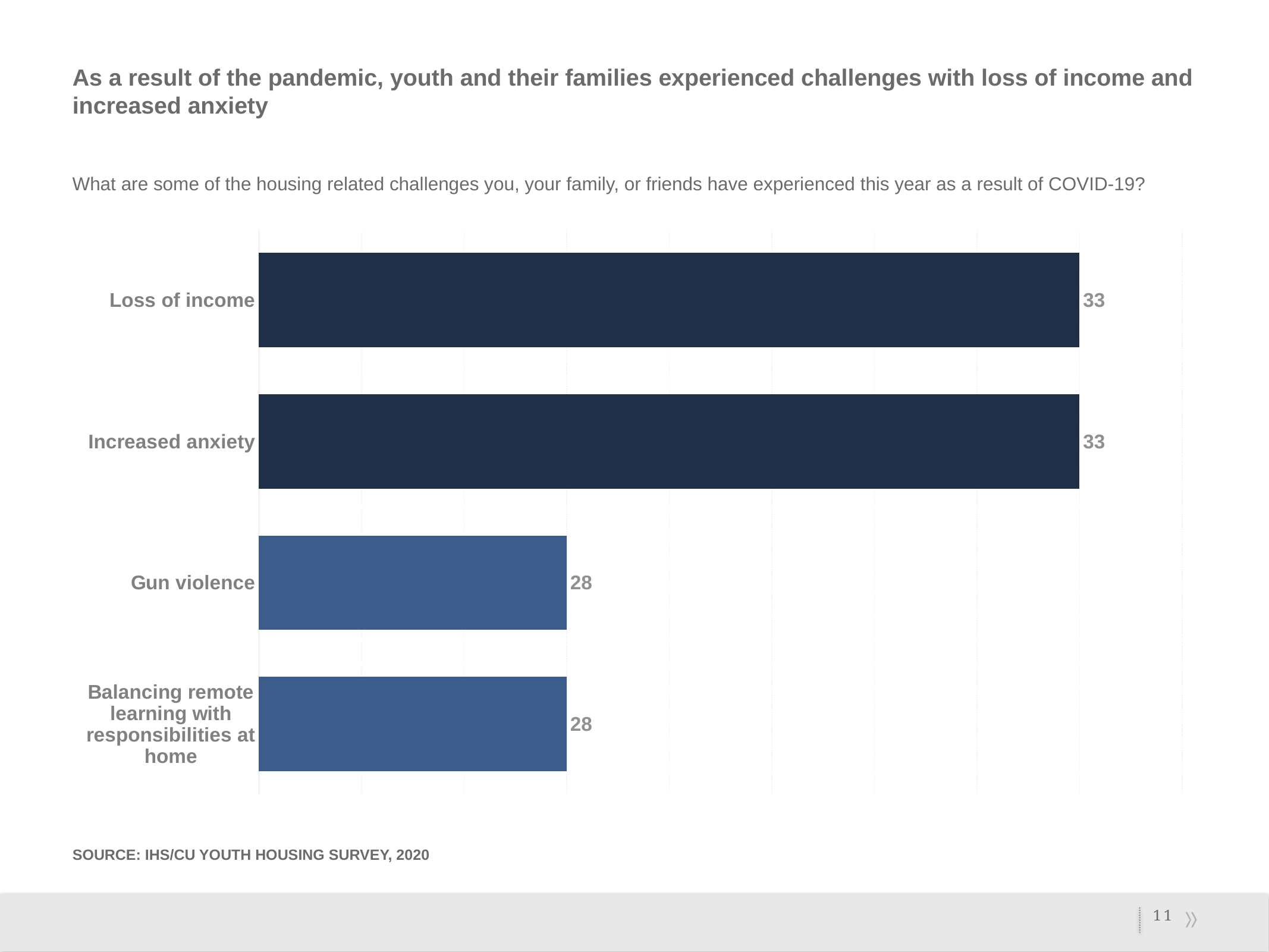
What is the value for Balancing remote learning with responsibilities at home? 28 How many categories are shown in the chart? 4 What kind of chart is shown on the slide? Bar chart Which two categories share the highest value in the chart? Loss of income and Increased anxiety What is the value for Increased anxiety? 33 Which two categories share the lowest value in the chart? Gun violence and Balancing remote learning with responsibilities at home What is the difference between the values for Loss of income and Increased anxiety? 0 What is the difference between the values for Loss of income and Gun violence? 5 Which is larger, the value for Increased anxiety or the value for Balancing remote learning with responsibilities at home? Increased anxiety What is the value for Gun violence? 28 What source is cited below the chart? IHS/CU Youth Housing Survey, 2020 What is the value for Loss of income? 33